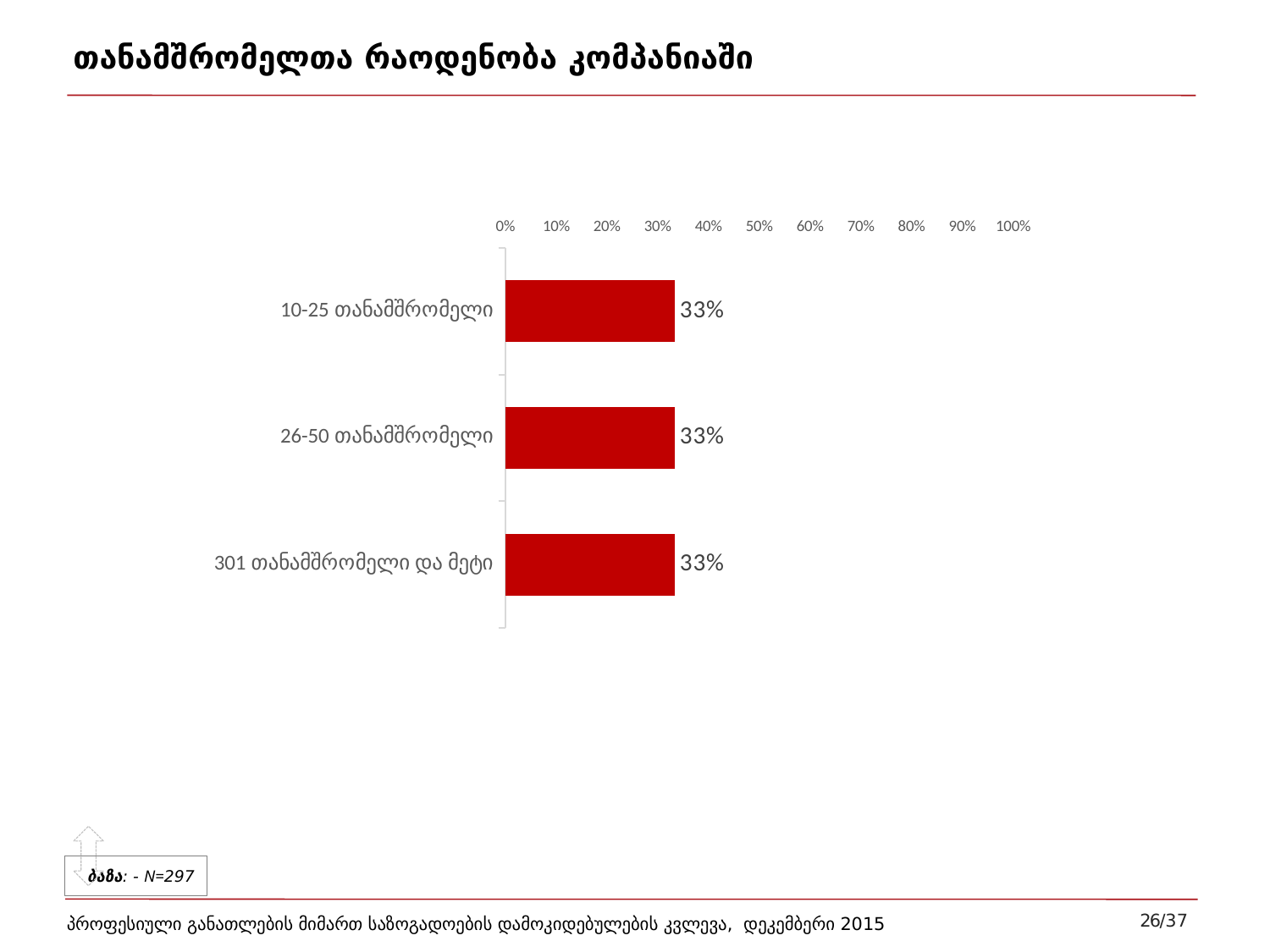
What is the value for 26-50 თანამშრომელი? 33% What colour are the bars in the chart? red What kind of chart is shown on the slide? bar chart Is the value for 26-50 თანამშრომელი greater or less than 50%? less What is the value for 301 თანამშრომელი და მეტი? 33% How many categories are shown in the chart? 3 Is the value for 10-25 თანამშრომელი greater or less than 30%? greater What is the difference between the values for 10-25 თანამშრომელი and 26-50 თანამშრომელი? 0% What is the value for 10-25 თანამშრომელი? 33% Is the value for 301 თანამშრომელი და მეტი greater or less than 40%? less What is the title of the slide? თანამშრომელთა რაოდენობა კომპანიაში Do all three categories have the same value? Yes